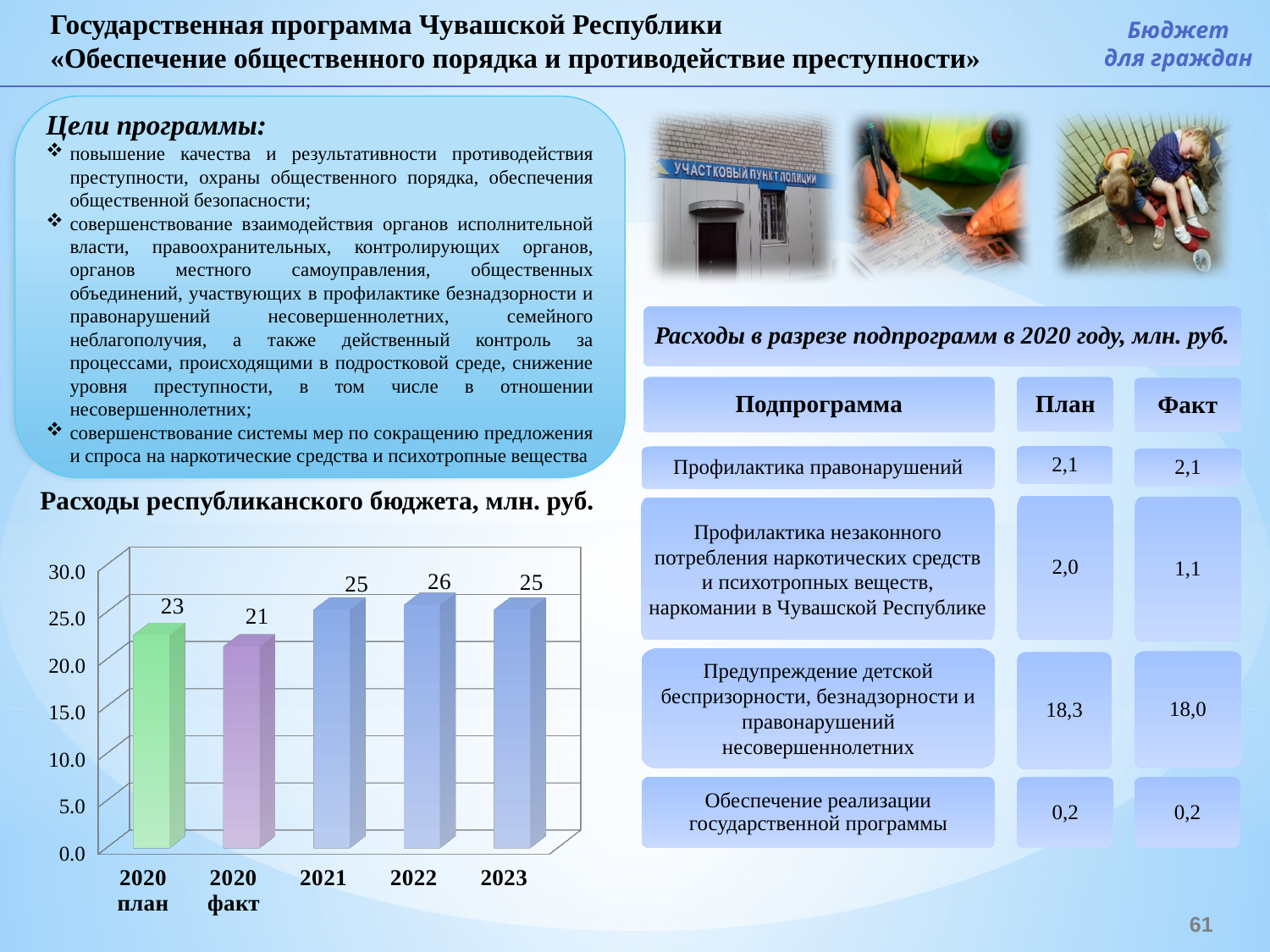
What is the value for 2020 план in the chart 'Расходы республиканского бюджета, млн. руб.'? 23 Which is larger, the value for 2021 or the value for 2022? 2022 What kind of chart is shown on the slide? bar chart Is the value for 2020 факт greater or less than 25.0? less Which category has the lowest value in the chart? 2020 факт What is the value for 2022 in the chart? 26 What is the value for 2023 in the chart? 25 What is the value for 2020 факт in the chart? 21 What is the difference between the values for 2020 план and 2020 факт? 2 Which category has the highest value in the chart? 2022 How many categories are shown on the x axis of the chart? 5 What is the title of the chart on the slide? Расходы республиканского бюджета, млн. руб.